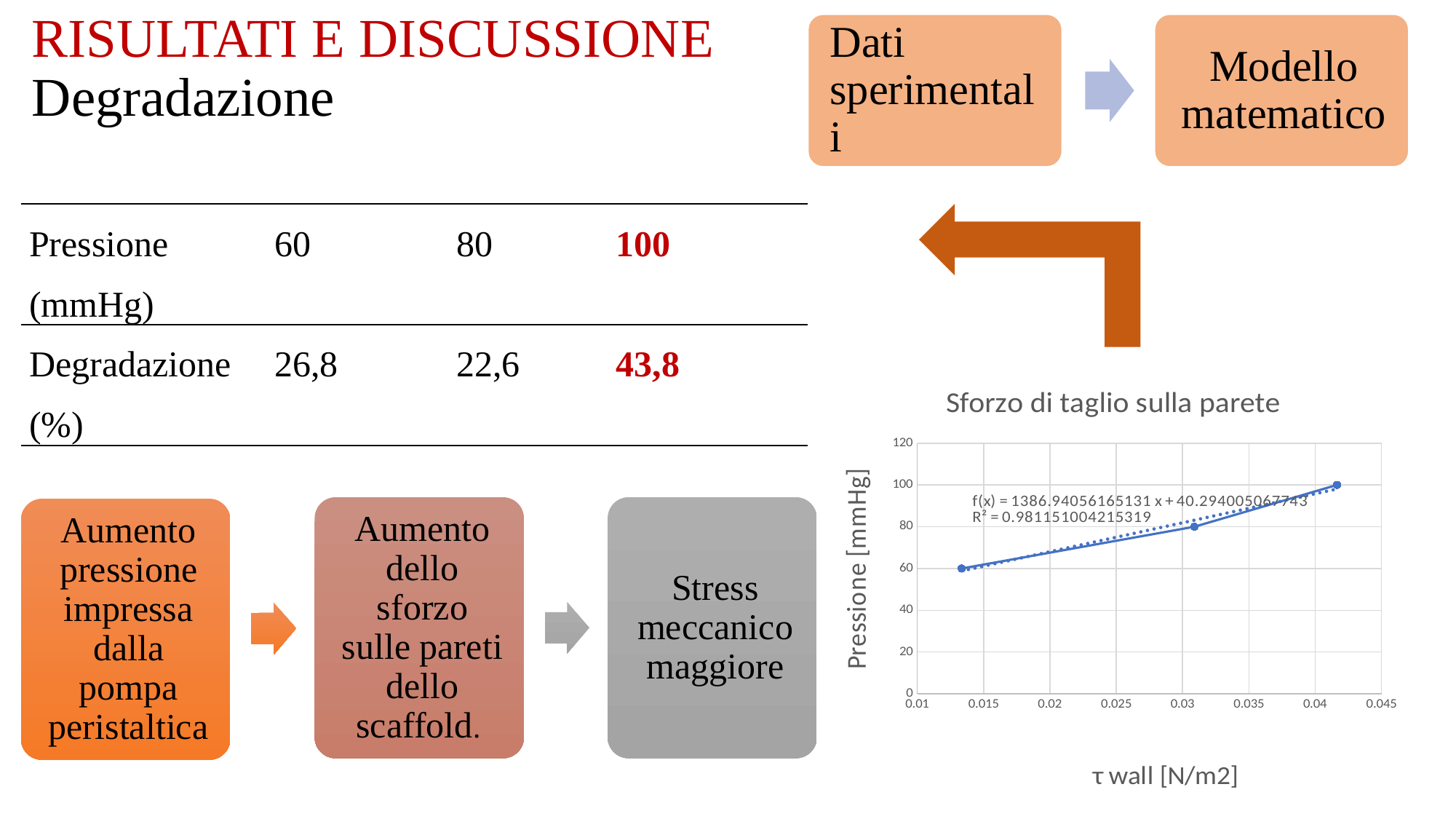
What is the label of the y axis of the chart? Pressione [mmHg] Do the plotted values rise or fall as τ wall increases along the x axis? rise What is the title of the chart on the slide? Sforzo di taglio sulla parete What kind of chart is shown on the slide? line chart Is the τ wall value of the point at 100 mmHg greater or less than 0.04? greater What is the R² value shown for the trendline in the chart? 0.981151004215319 How many data points are plotted in the chart? 3 What is the highest pressure value plotted in the chart? 100 Which plotted point has the larger pressure: the one at the smallest τ wall or the one at the largest τ wall? the one at the largest τ wall Is the τ wall value of the point at 60 mmHg greater or less than 0.015? less What is the difference in pressure between the highest and lowest plotted points? 40 What is the lowest pressure value plotted in the chart? 60